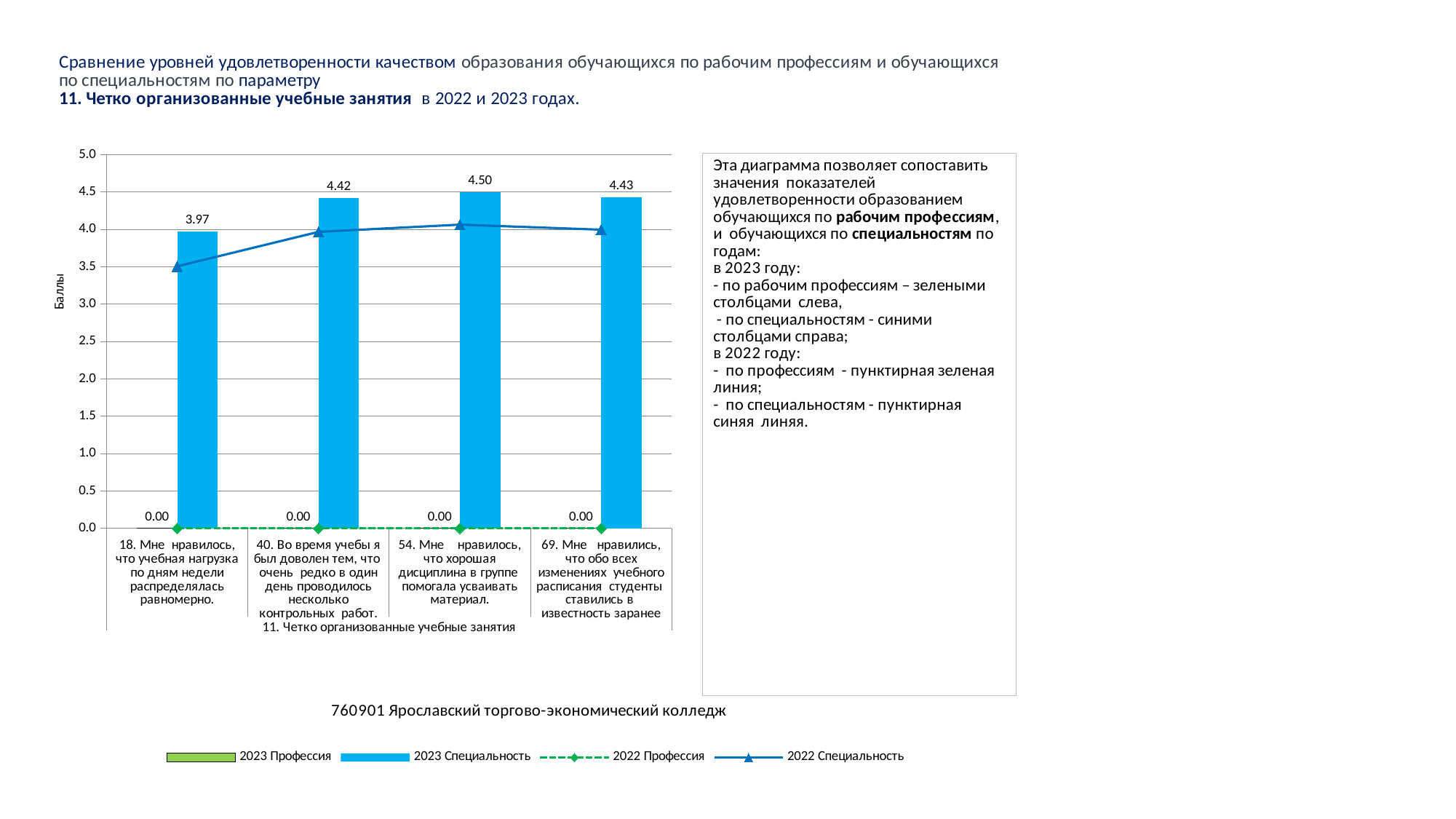
What is the value of the 2023 Специальность bar for category 69 (Мне нравились, что обо всех изменениях учебного расписания студенты ставились в известность заранее)? 4.43 Which category has the highest 2023 Специальность value? 54. Мне нравилось, что хорошая дисциплина в группе помогала усваивать материал. What is the value of the 2023 Специальность bar for category 54 (Мне нравилось, что хорошая дисциплина в группе помогала усваивать материал)? 4.50 How many categories are shown on the x axis? 4 Which category has the lowest 2023 Специальность value? 18. Мне нравилось, что учебная нагрузка по дням недели распределялась равномерно. Is the 2022 Специальность value for category 18 greater or less than 4.0? less What is the difference between the 2023 Специальность values for category 54 and category 18? 0.53 Which is larger, the 2023 Специальность value for category 40 or for category 18? Category 40 (4.42) What is the value of the 2023 Профессия series for category 40 (Во время учебы я был доволен тем, что очень редко в один день проводилось несколько контрольных работ)? 0.00 What is the value of the 2023 Специальность bar for category 18 (Мне нравилось, что учебная нагрузка по дням недели распределялась равномерно)? 3.97 What is the label of the vertical axis? Баллы How many series does the legend list? 4